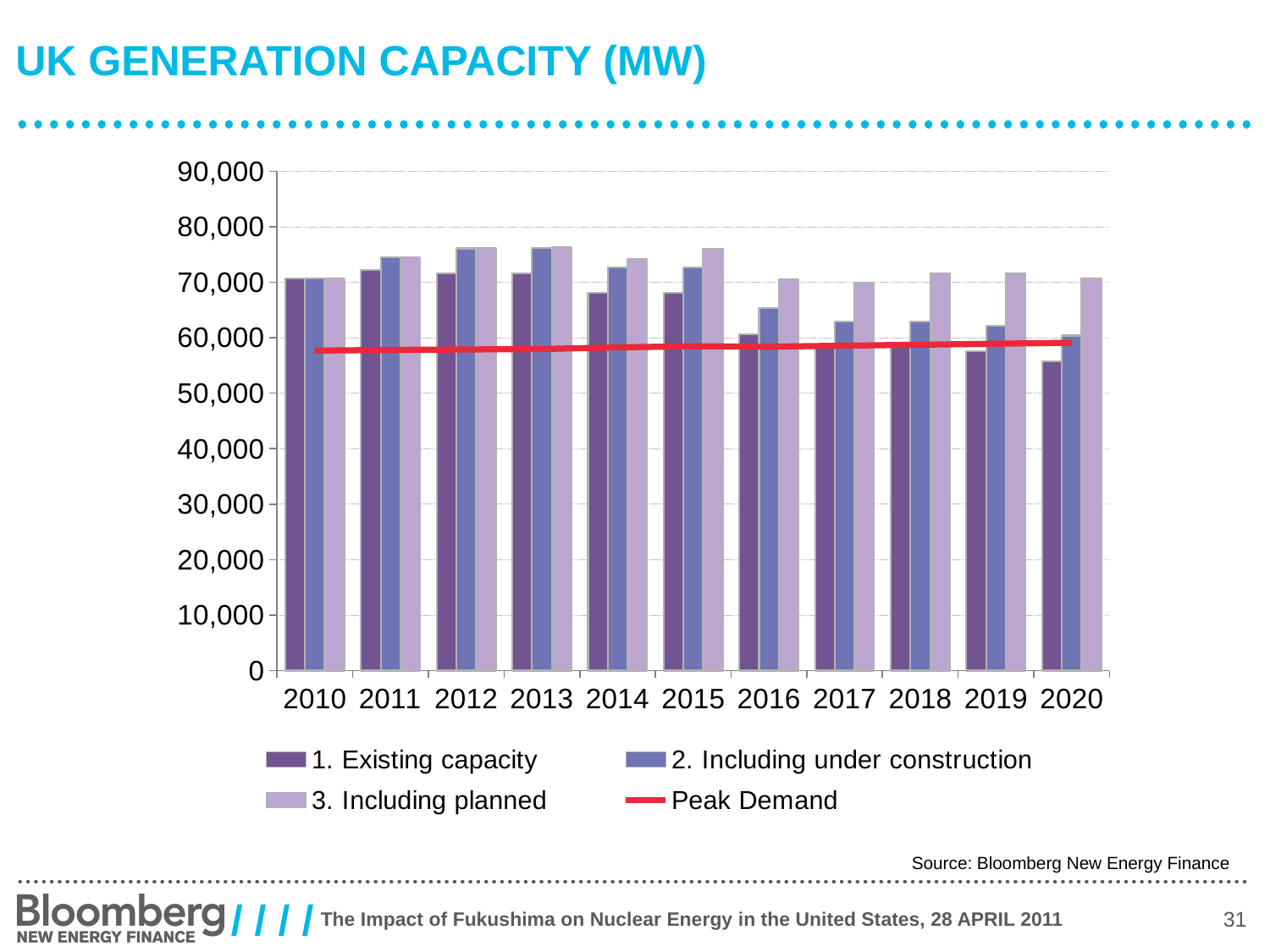
Which is larger, the Existing capacity in 2010 or in 2020? 2010 Is the Existing capacity for 2020 greater or less than 60,000? less Is the Including planned value for 2013 greater or less than 70,000? greater What is the title of the chart? UK GENERATION CAPACITY (MW) Which year has the lowest Existing capacity? 2020 Is the Existing capacity for 2014 greater or less than 70,000? less How many series does the legend list? 4 How many years are shown on the x axis? 11 What kind of chart is shown on the slide? Bar chart (with a line for Peak Demand) Does the Existing capacity series rise or fall from 2010 to 2020? Fall Which series is drawn as a red line? Peak Demand